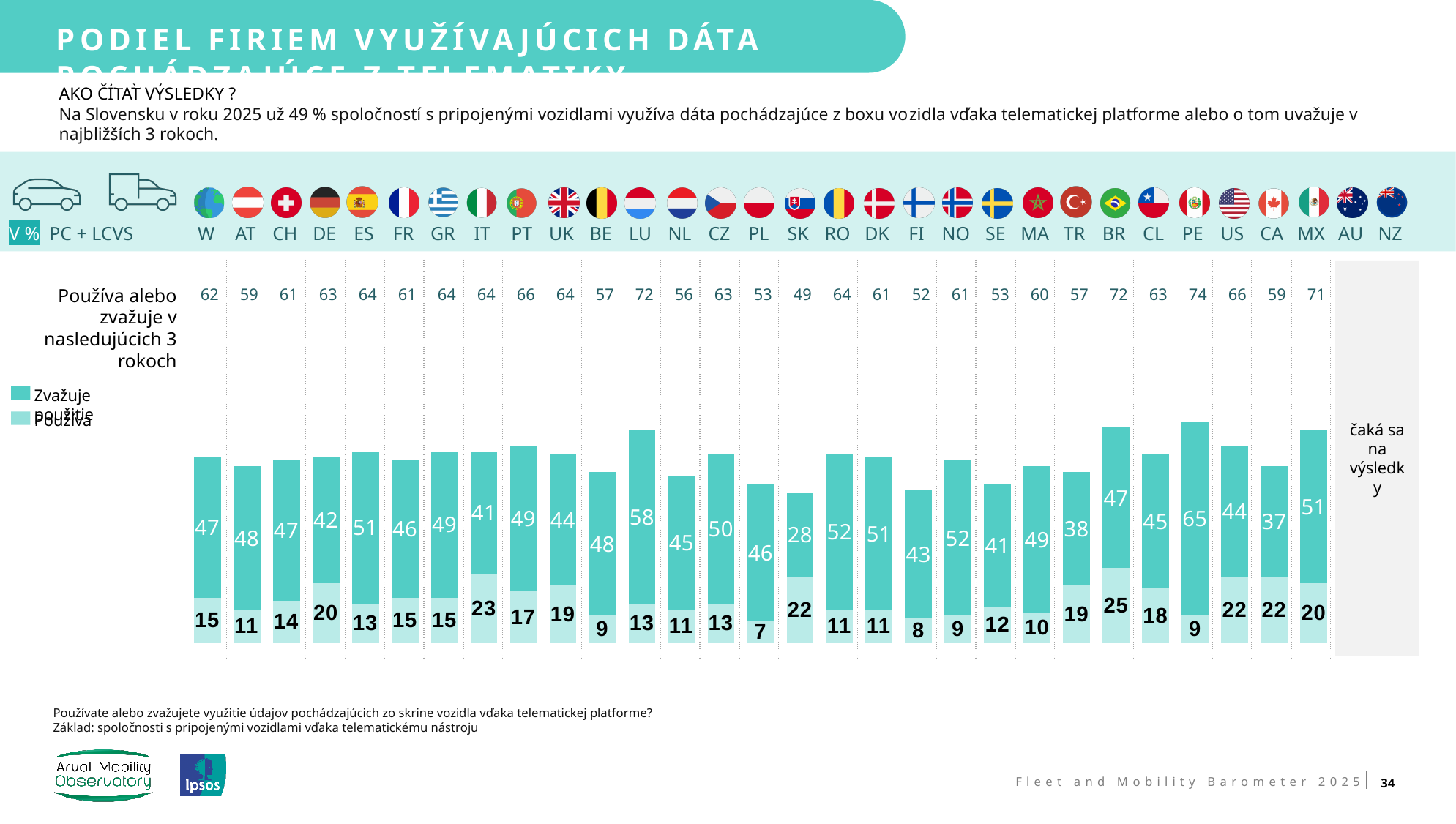
Which has a larger 'Používa alebo zvažuje v nasledujúcich 3 rokoch' value, MX or US? MX What is the difference between the 'Používa' values for IT and AT? 12 Which country has the lowest 'Používa' value? PL What is the 'Používa' value for BR? 25 What is the 'Používa alebo zvažuje v nasledujúcich 3 rokoch' value for SK? 49 Which country has the highest 'Používa alebo zvažuje v nasledujúcich 3 rokoch' value? PE What type of chart is shown on the slide? stacked bar chart How many series does the legend list? 2 Which countries are marked as awaiting results ('čaká sa na výsledky')? AU and NZ What is the 'Zvažuje použitie' value for LU? 58 Which country has the lowest 'Zvažuje použitie' value? SK What is the 'Používa' value for W? 15